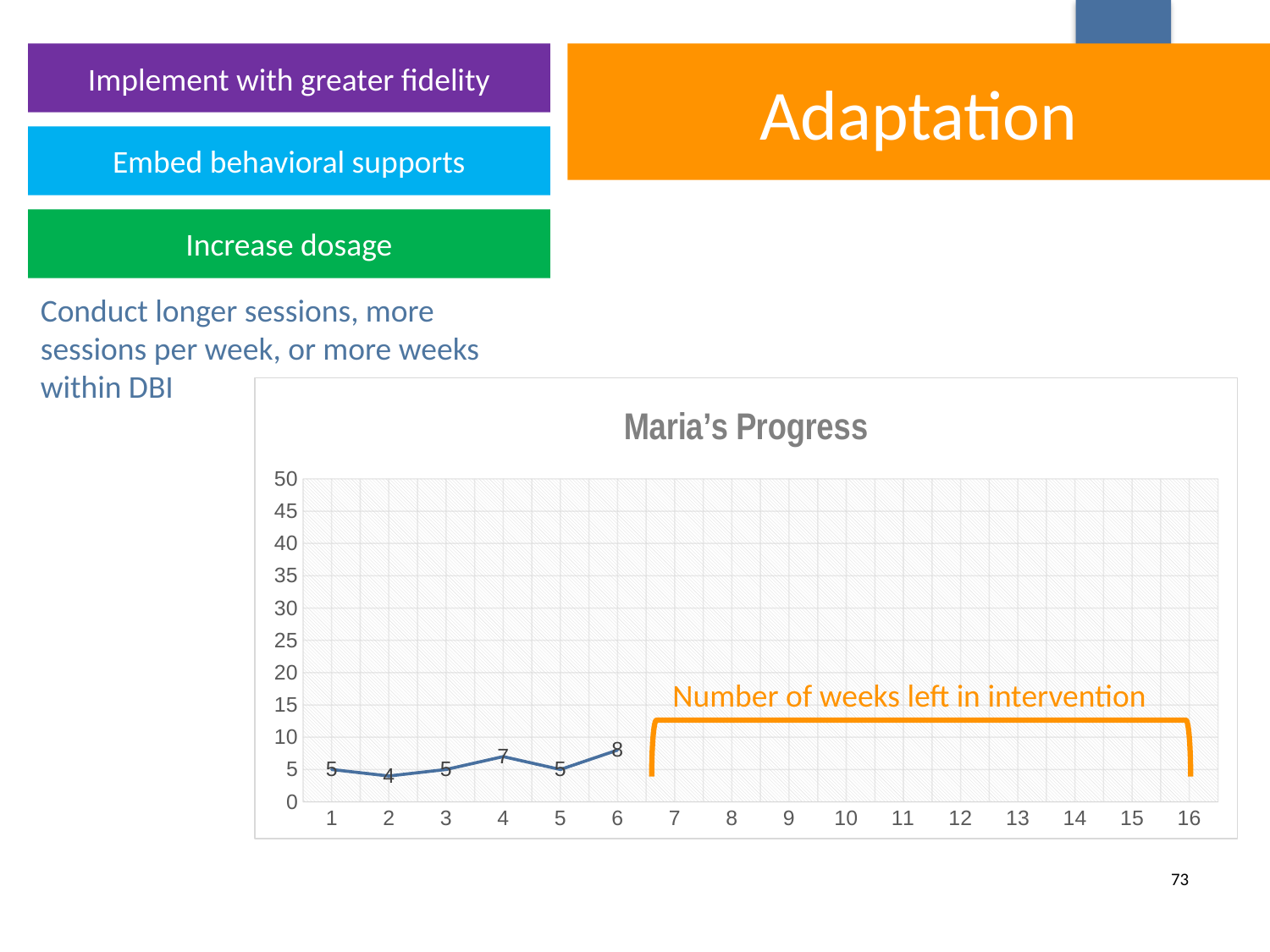
What is the value plotted at week 4 in Maria's Progress? 7 What is the difference between the values at week 6 and week 2? 4 Which is larger, the value at week 4 or the value at week 5? week 4 What is the value plotted at week 6 in Maria's Progress? 8 Is the value at week 6 greater or less than 10? less What is the value plotted at week 2 in Maria's Progress? 4 What is the title of the chart? Maria's Progress What kind of chart is shown on the slide? line chart At which week is the plotted value highest? 6 At which week is the plotted value lowest? 2 What is the value plotted at week 1 in Maria's Progress? 5 How many data points are plotted on the line? 6